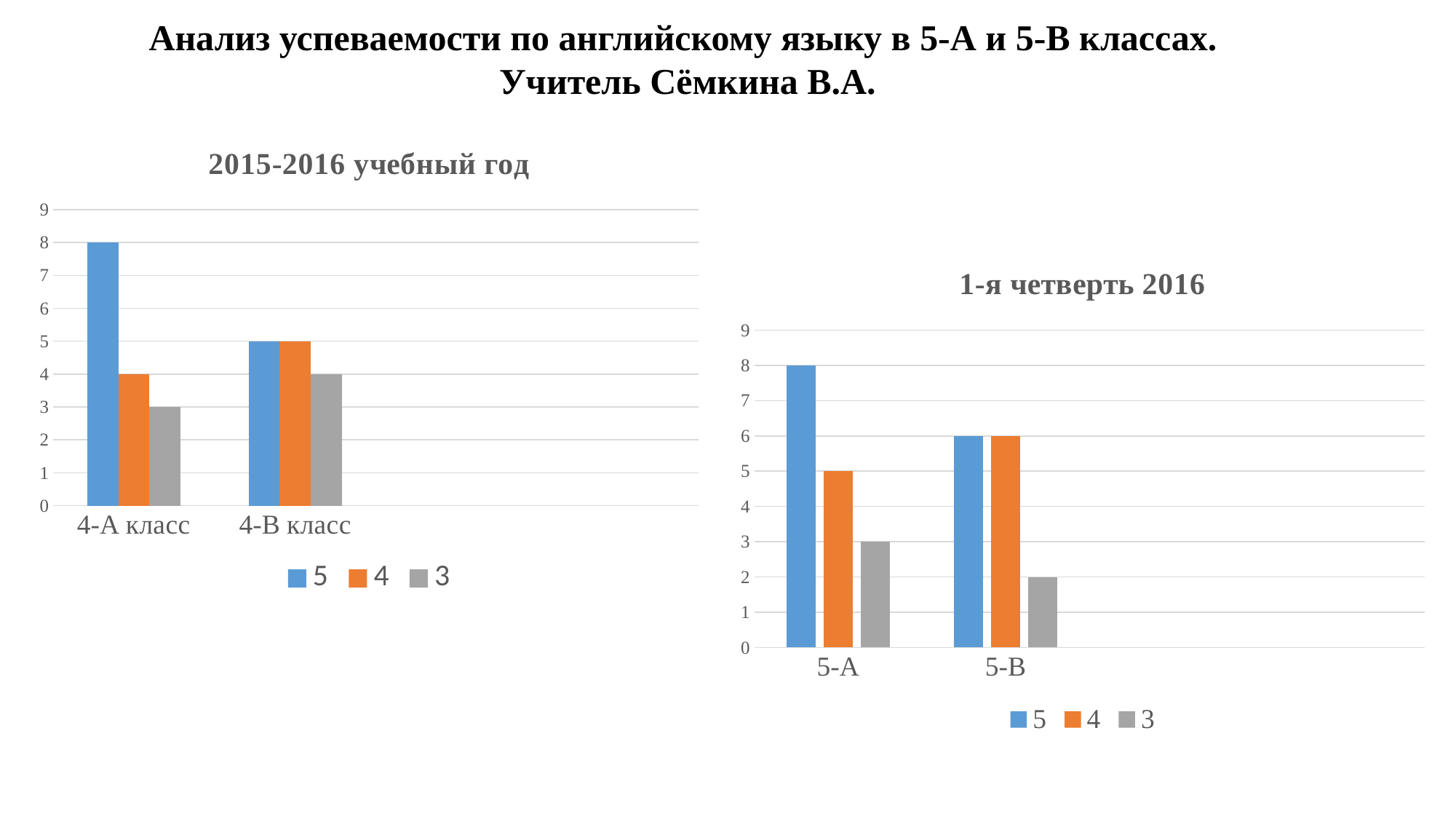
In the chart titled "1-я четверть 2016", what is the value of series "4" for "5-А"? 5 In the chart titled "2015-2016 учебный год", how many categories are shown on the x axis? 2 In the chart titled "2015-2016 учебный год", what is the value of series "3" for "4-В класс"? 4 In the chart titled "2015-2016 учебный год", what colour represents series "4"? Orange In the chart titled "1-я четверть 2016", which is larger: the series "5" value for "5-А" or for "5-В"? 5-А In the chart titled "2015-2016 учебный год", which series has the highest value for "4-А класс"? 5 In the chart titled "1-я четверть 2016", which series has the lowest value for "5-В"? 3 In the chart titled "2015-2016 учебный год", what is the difference between the series "5" values for "4-А класс" and "4-В класс"? 3 In the chart titled "1-я четверть 2016", how many series does the legend list? 3 What type of chart is the chart titled "1-я четверть 2016"? Bar chart In the chart titled "2015-2016 учебный год", what is the value of series "5" for "4-А класс"? 8 In the chart titled "1-я четверть 2016", what is the value of series "3" for "5-В"? 2